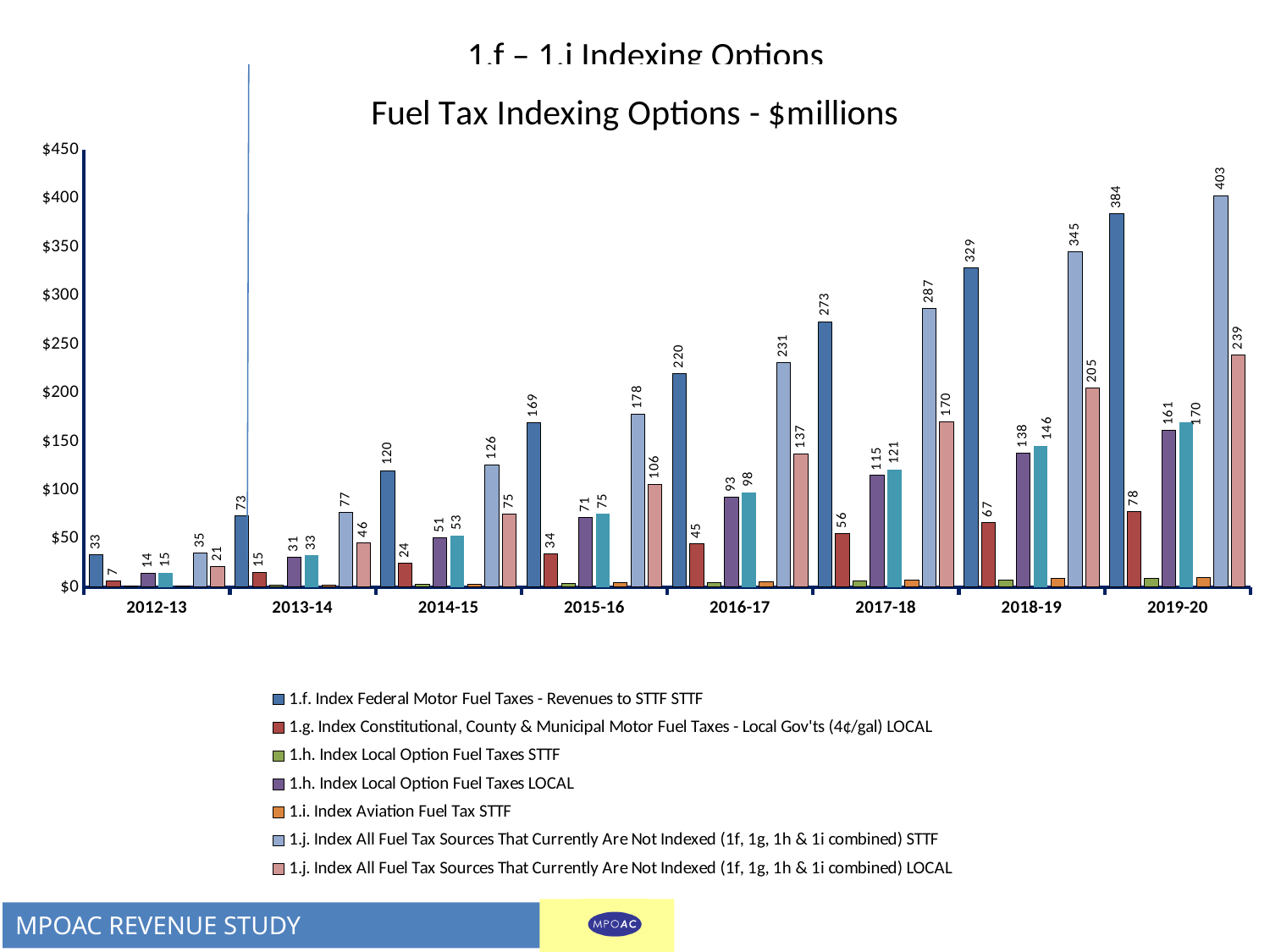
What is the value for 1.g. Index Constitutional, County & Municipal Motor Fuel Taxes LOCAL in 2017-18? 56 In which fiscal year is the 1.j. Index All Fuel Tax Sources STTF value the highest? 2019-20 How many fiscal years are shown on the x axis? 8 What kind of chart is shown on the slide? Bar chart In which fiscal year is the 1.f. Index Federal Motor Fuel Taxes STTF value the lowest? 2012-13 How many series does the legend list? 7 Do the values for 1.f. Index Federal Motor Fuel Taxes STTF rise or fall from 2012-13 to 2019-20? Rise What is the value for 1.f. Index Federal Motor Fuel Taxes - Revenues to STTF in 2019-20? 384 Which is larger: the 1.f. Index Federal Motor Fuel Taxes STTF value in 2018-19 or the 1.j. Index All Fuel Tax Sources LOCAL value in 2019-20? 1.f. Index Federal Motor Fuel Taxes STTF in 2018-19 In 2019-20, what is the difference between the 1.j. Index All Fuel Tax Sources STTF value and the 1.f. Index Federal Motor Fuel Taxes STTF value? 19 What is the value for 1.j. Index All Fuel Tax Sources That Currently Are Not Indexed LOCAL in 2014-15? 75 What is the value for 1.j. Index All Fuel Tax Sources That Currently Are Not Indexed STTF in 2016-17? 231